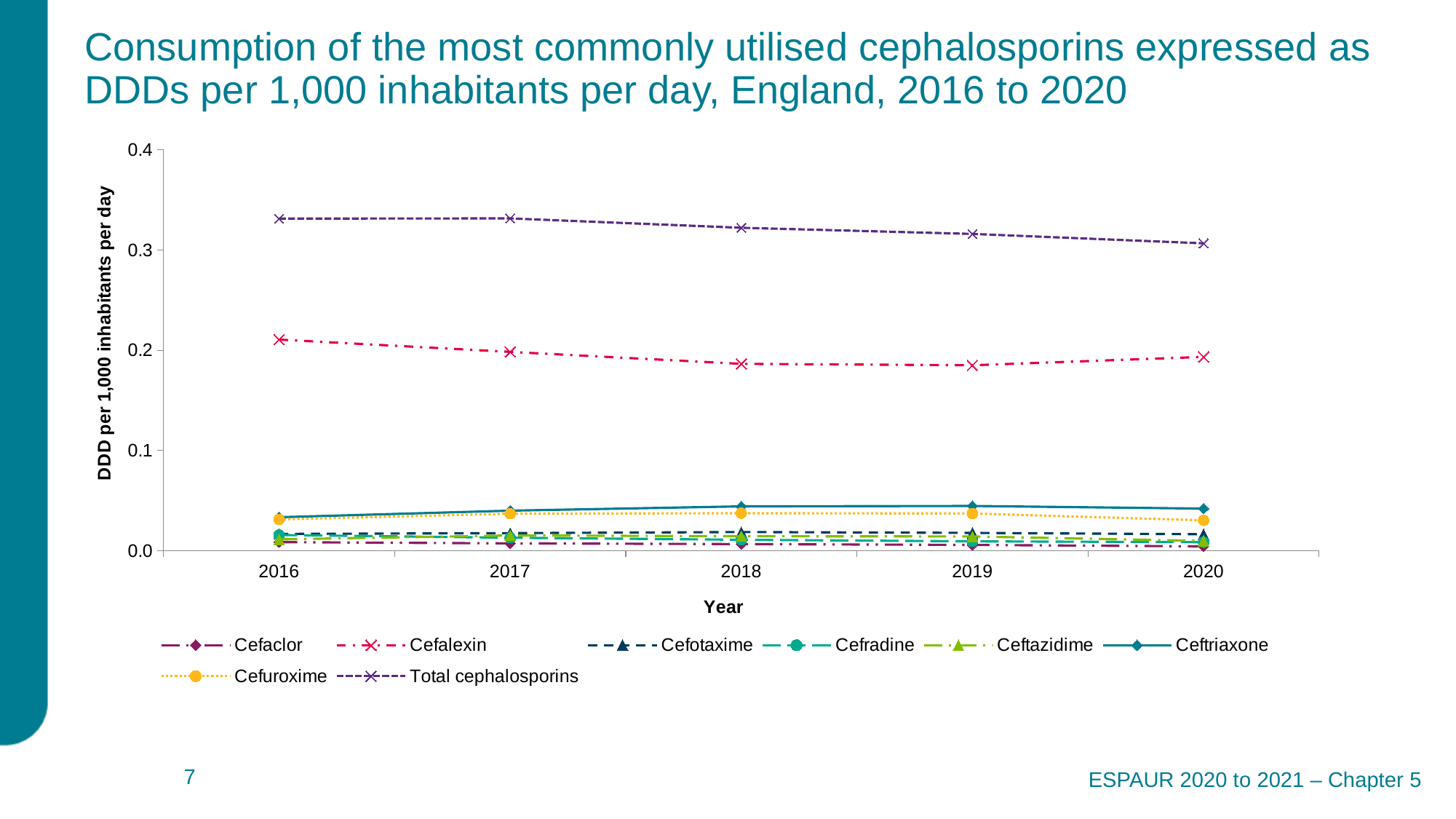
What is the title of the x axis? Year Does the Total cephalosporins line rise or fall from 2016 to 2020? Fall What kind of chart is shown on the slide? Line chart Is the value for Cefalexin in 2016 greater or less than 0.2? greater Which series has the highest values across all years? Total cephalosporins Which individual cephalosporin (excluding the total) has the highest consumption in every year shown? Cefalexin How many series does the legend list? 8 How many years are plotted along the x axis? 5 Is the value for Total cephalosporins in 2016 greater or less than 0.3? greater In 2018, which is larger: the value for Cefalexin or the value for Ceftriaxone? Cefalexin Is the value for Ceftriaxone in 2018 greater or less than 0.1? less